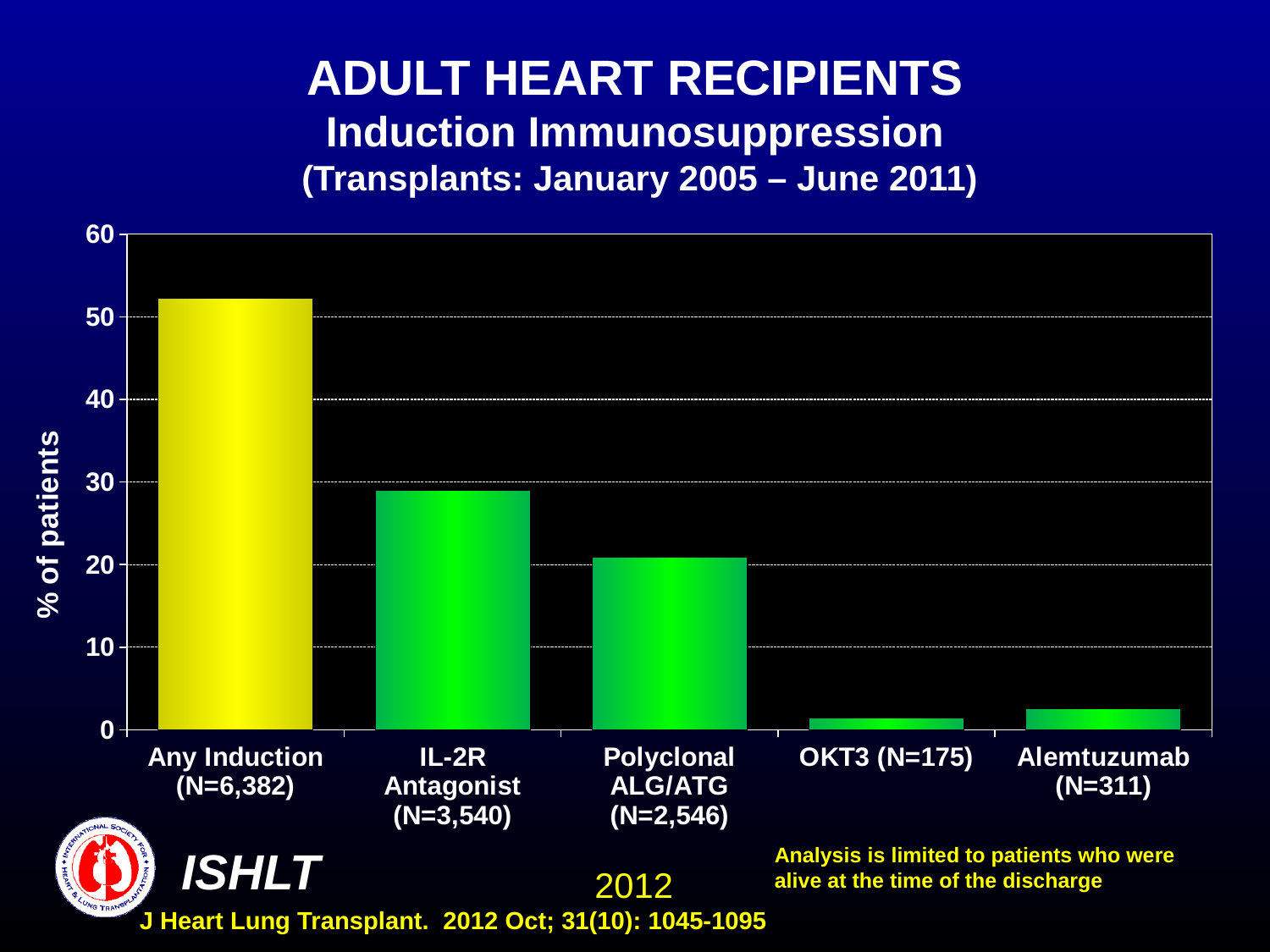
Which is larger, the value for IL-2R Antagonist (N=3,540) or the value for Polyclonal ALG/ATG (N=2,546)? IL-2R Antagonist (N=3,540) Which category has the highest percentage of patients? Any Induction (N=6,382) What is the label of the y axis? % of patients Is the value for Polyclonal ALG/ATG (N=2,546) greater or less than 20? greater What kind of chart is shown on the slide? bar chart Is the value for IL-2R Antagonist (N=3,540) greater or less than 30? less Which is larger, the value for OKT3 (N=175) or the value for Alemtuzumab (N=311)? Alemtuzumab (N=311) What transplant date range is given in the chart title? January 2005 – June 2011 Which category has the lowest percentage of patients? OKT3 (N=175) Is the value for Any Induction (N=6,382) greater or less than 50? greater How many induction categories are plotted on the x axis? 5